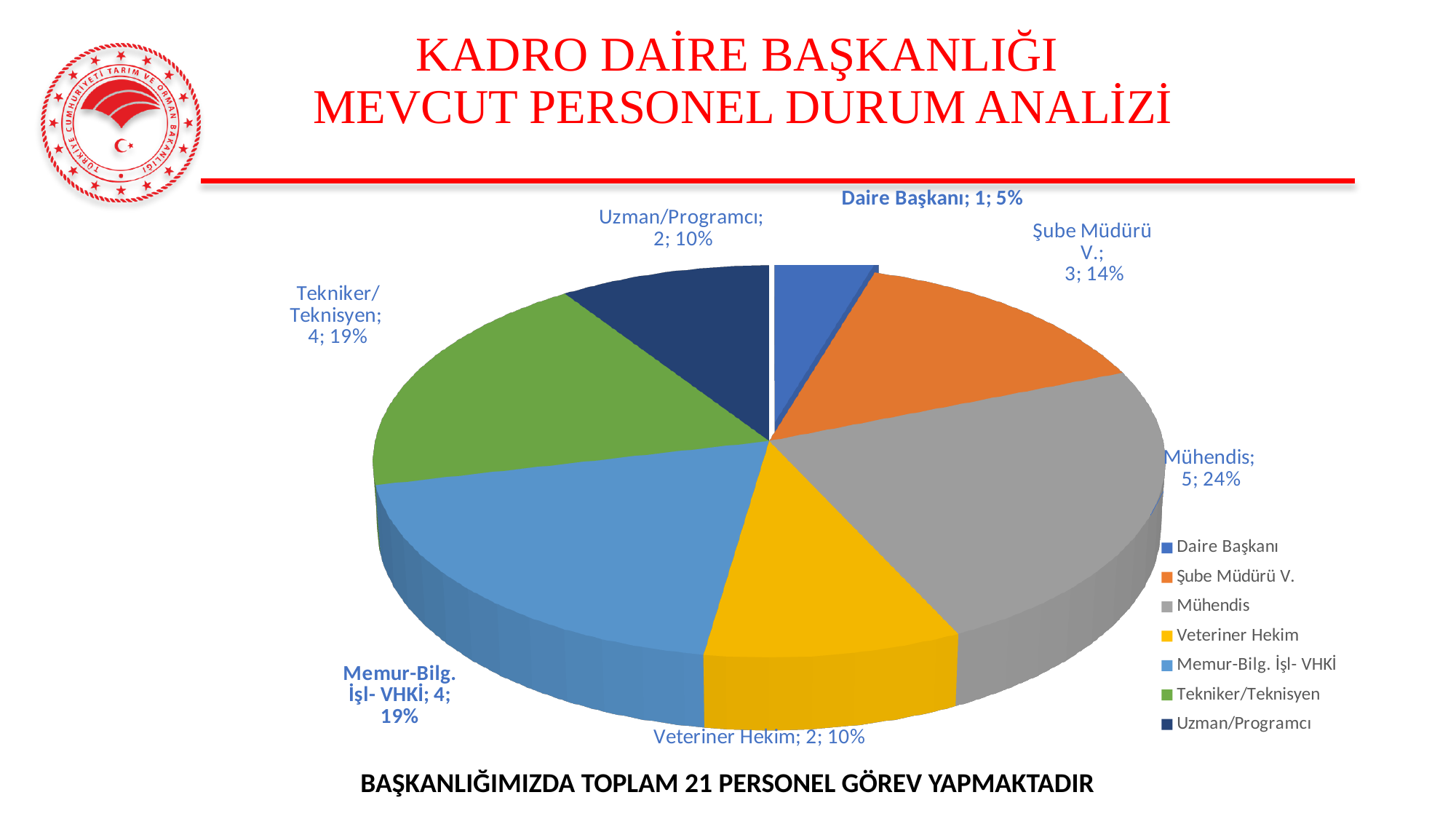
How many entries does the legend list? 7 What percentage share does the Tekniker/Teknisyen slice have? 19% How many personnel are in the Mühendis category? 5 What is the difference in personnel count between Mühendis and Şube Müdürü V.? 2 What percentage share does the Daire Başkanı slice have? 5% Which category has the smallest slice of the pie? Daire Başkanı What kind of chart is shown on the slide? Pie chart How many personnel are in the Uzman/Programcı category? 2 Which has more personnel, Veteriner Hekim or Memur-Bilg. İşl- VHKİ? Memur-Bilg. İşl- VHKİ How many slices does the pie chart have? 7 What colour is the Mühendis slice in the pie chart? Grey Which category has the largest slice of the pie? Mühendis